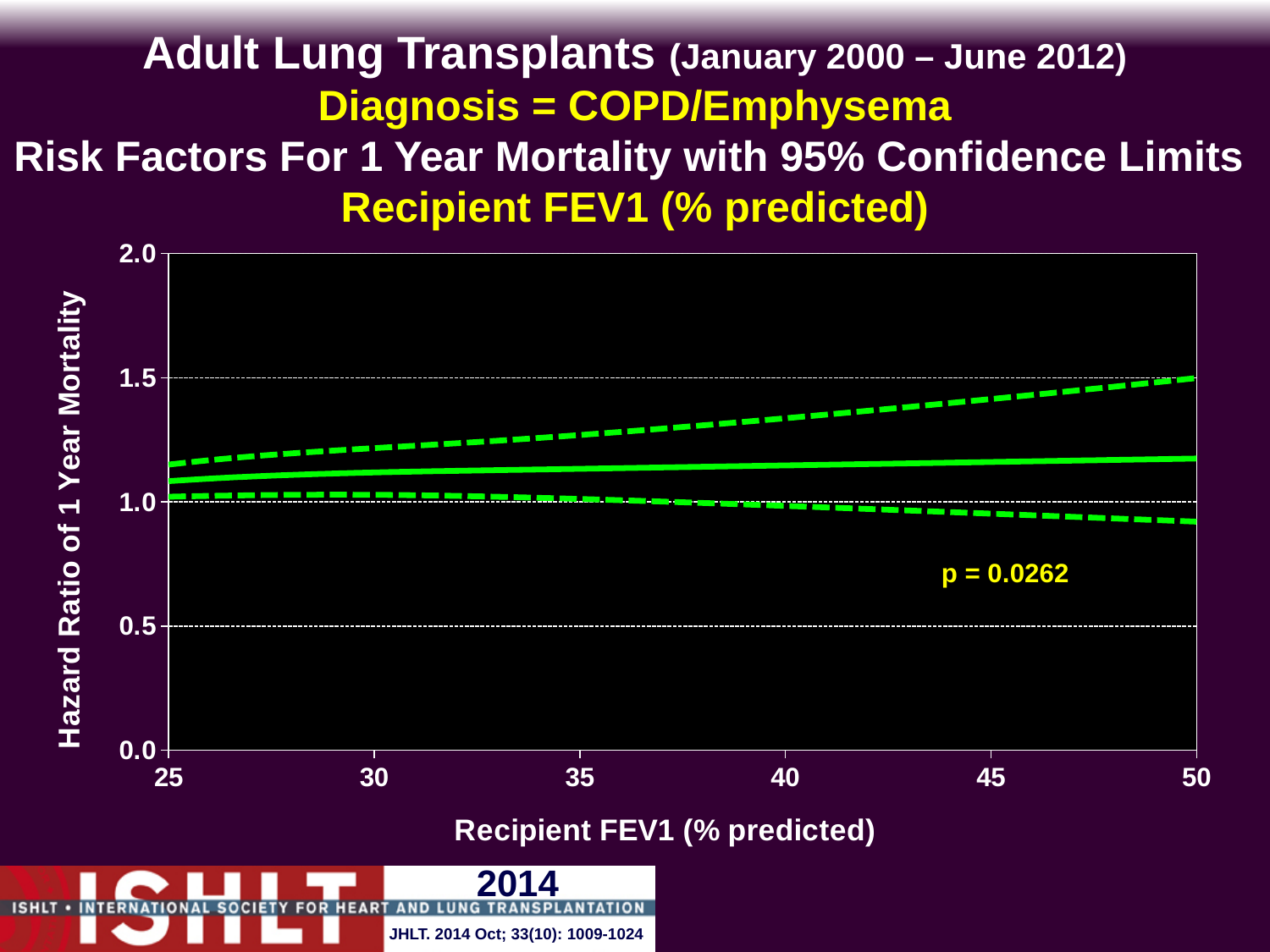
How many lines are plotted on the chart? 3 Is the hazard ratio (solid line) at Recipient FEV1 of 50% predicted greater or less than 1.0? greater What is the label of the y axis? Hazard Ratio of 1 Year Mortality What is the highest value shown on the y axis? 2.0 Is the upper 95% confidence limit (upper dashed line) at Recipient FEV1 of 25% predicted greater or less than 1.5? less Does the solid hazard ratio line rise or fall as Recipient FEV1 (% predicted) increases from 25 to 50? rises What kind of chart is shown on the slide? line chart Is the lower 95% confidence limit (lower dashed line) at Recipient FEV1 of 50% predicted greater or less than 1.0? less What is the lowest value shown on the x axis? 25 What p-value is printed on the chart? p = 0.0262